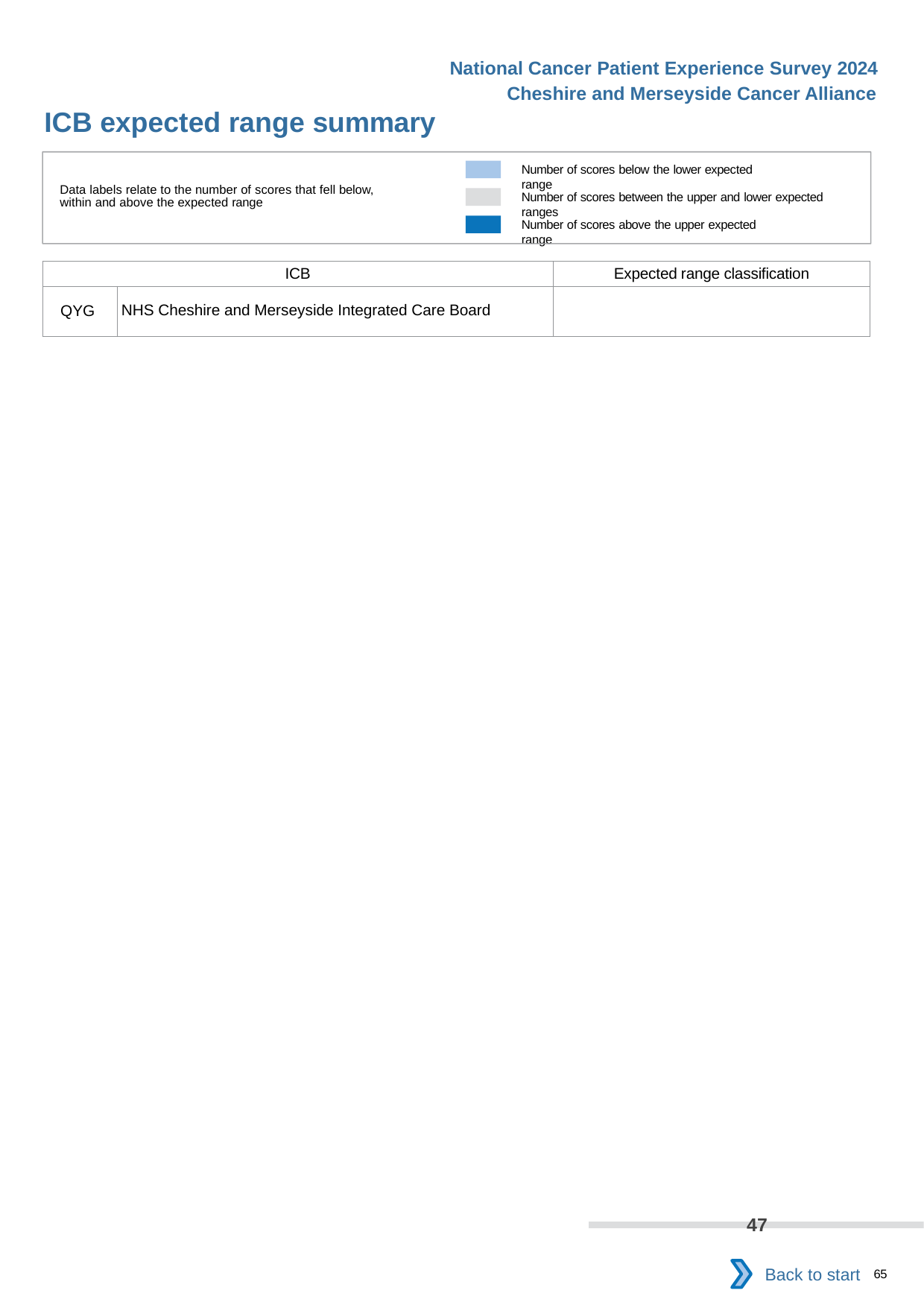
According to the legend, what does the dark blue colour represent? Number of scores above the upper expected range According to the legend, what does the grey colour represent? Number of scores between the upper and lower expected ranges How many categories does the legend at the top of the slide list? 3 What kind of chart is shown near the bottom of the slide? bar chart What value is printed as the data label on the grey bar near the bottom of the slide? 47 How many bars are plotted in the chart near the bottom of the slide? 1